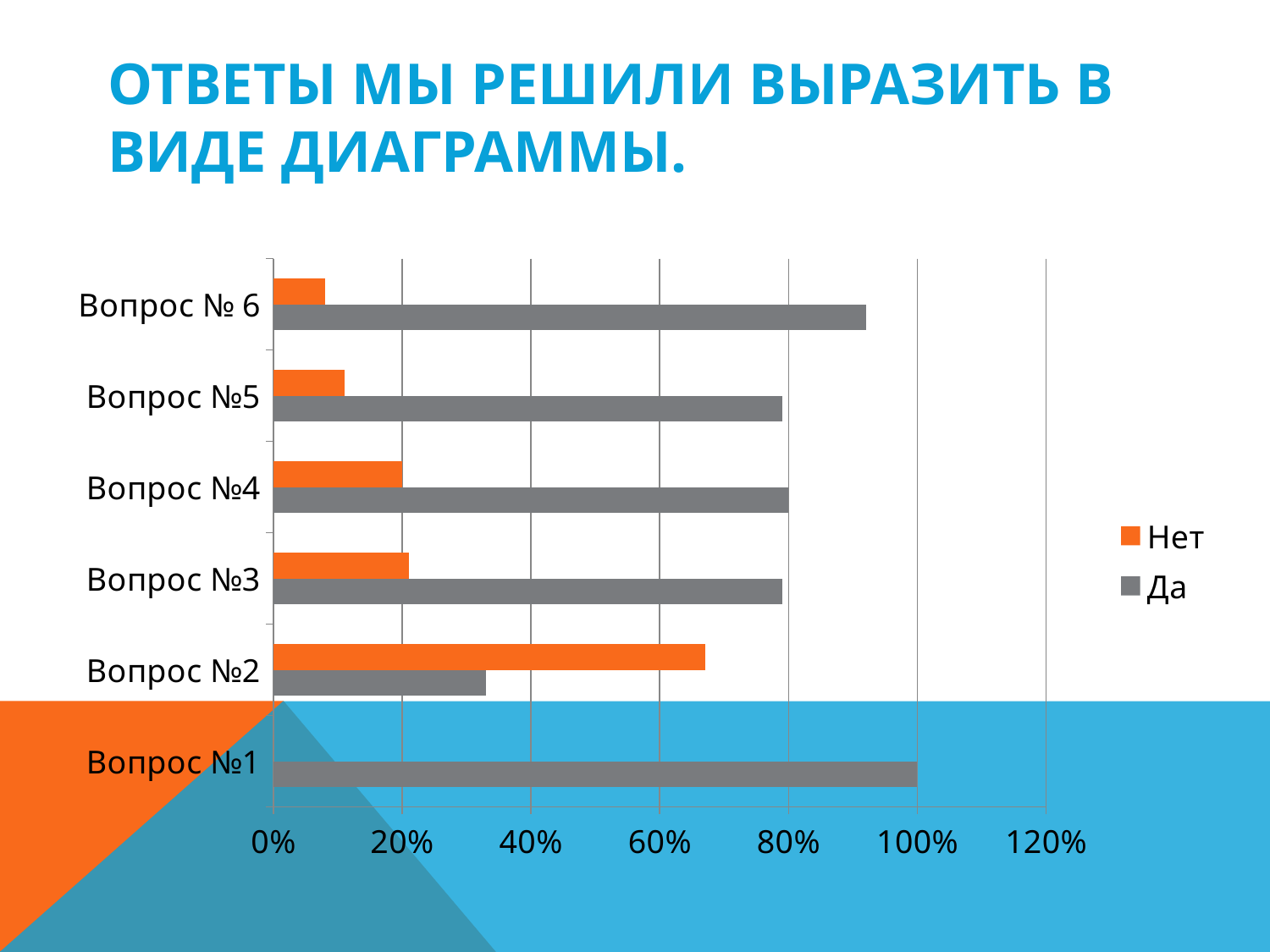
How many series does the legend list? 2 Is the value of the Нет series for Вопрос №2 greater or less than 60%? greater For Вопрос №2, which series has the larger value, Нет or Да? Нет What is the value of the Да series for Вопрос №1? 100% Which question has the lowest value for the Да series? Вопрос №2 How many categories (questions) are shown on the chart? 6 What are the two legend entries of the chart? Нет, Да Which question has the highest value for the Да series? Вопрос №1 Is the value of the Да series for Вопрос № 6 greater or less than 80%? greater Which question has the highest value for the Нет series? Вопрос №2 What kind of chart is shown on the slide? bar chart Is the value of the Нет series for Вопрос №5 greater or less than 20%? less